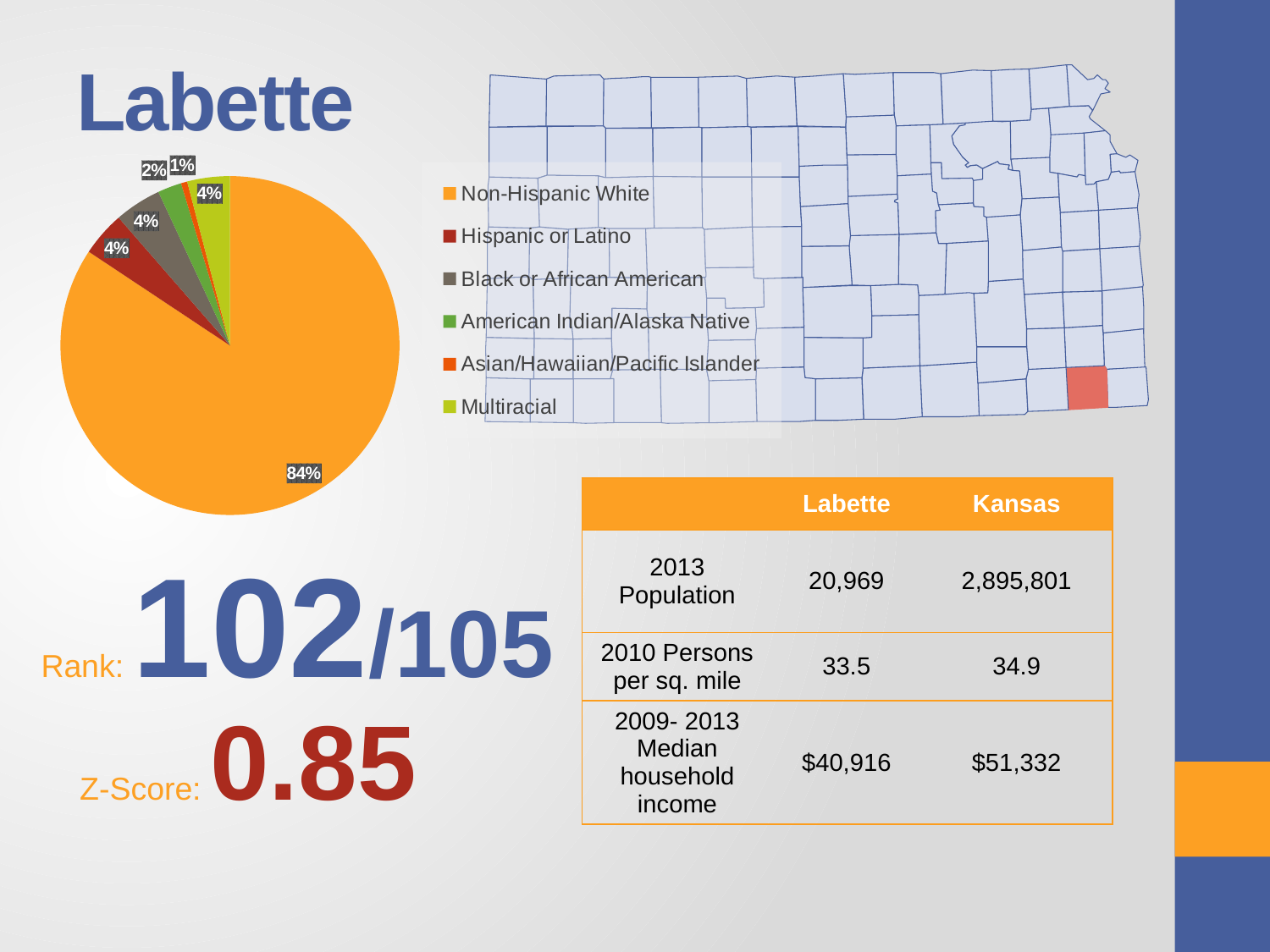
What is the difference in percentage points between the Non-Hispanic White slice and the Black or African American slice? 80 What type of chart is shown on the slide? pie chart What colour is the Non-Hispanic White slice in the pie chart? orange Which slice is larger: American Indian/Alaska Native or Asian/Hawaiian/Pacific Islander? American Indian/Alaska Native Which category has the smallest slice of the pie chart? Asian/Hawaiian/Pacific Islander Which category has the largest slice of the pie chart? Non-Hispanic White What percentage of the pie chart is Hispanic or Latino? 4% What percentage of the pie chart is Non-Hispanic White? 84% What percentage of the pie chart is Asian/Hawaiian/Pacific Islander? 1% What percentage of the pie chart is American Indian/Alaska Native? 2% What percentage of the pie chart is Multiracial? 4% How many categories does the pie chart legend list? 6